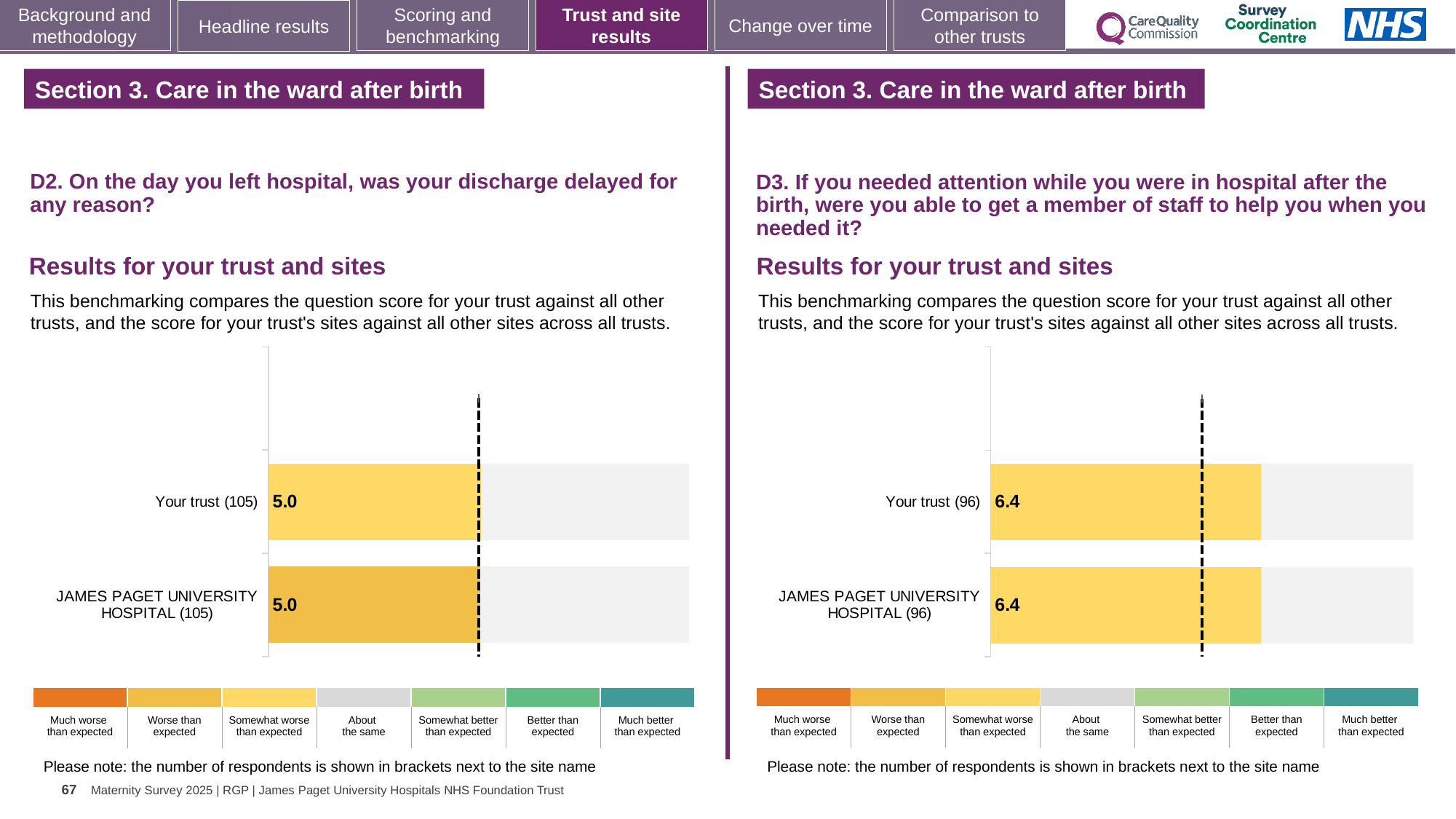
In the D3 chart on the right, what is the score for JAMES PAGET UNIVERSITY HOSPITAL? 6.4 In the D2 chart on the left, how many respondents are shown in brackets for Your trust? 105 How many bars are plotted in the D2 chart on the left? 2 How many bars are plotted in the D3 chart on the right? 2 In the D2 chart on the left, what is the score for JAMES PAGET UNIVERSITY HOSPITAL? 5.0 In the D3 chart on the right, how many respondents are shown in brackets for JAMES PAGET UNIVERSITY HOSPITAL? 96 In the D2 chart on the left, what is the difference between the Your trust score and the JAMES PAGET UNIVERSITY HOSPITAL score? 0.0 In the D3 chart on the right, what is the difference between the Your trust score and the JAMES PAGET UNIVERSITY HOSPITAL score? 0.0 In the D2 chart on the left, what is the score for Your trust? 5.0 In the D3 chart on the right, what is the score for Your trust? 6.4 What type of chart is used for the D2 results on the left? Bar chart In the D2 chart on the left, which benchmark category does the colour of the JAMES PAGET UNIVERSITY HOSPITAL bar correspond to in the legend? Worse than expected